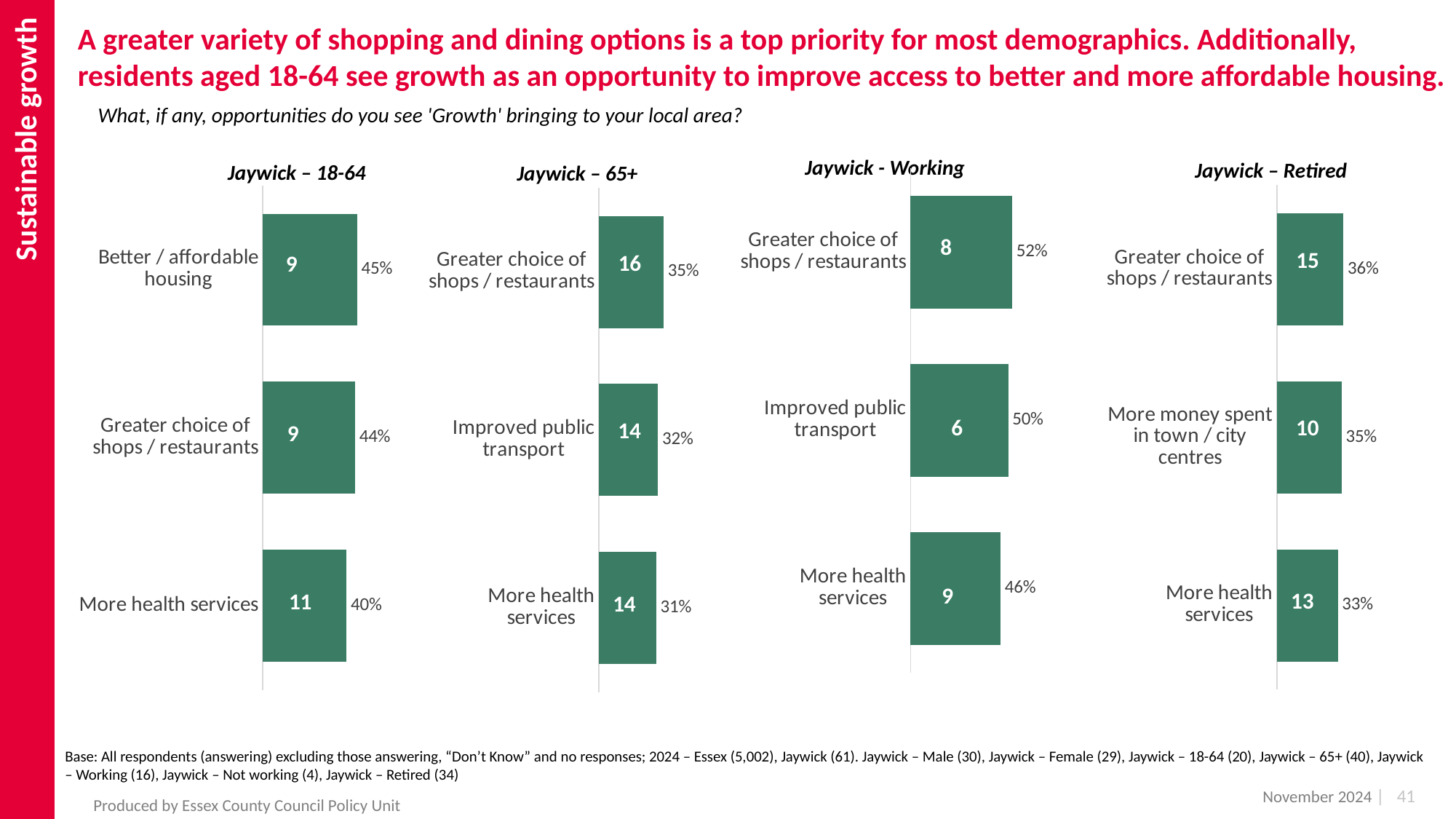
In the 'Jaywick – Retired' chart, what count is shown inside the bar for 'More money spent in town / city centres'? 10 How many categories are shown in the 'Jaywick – 65+' chart? 3 In the 'Jaywick – 65+' chart, which category has the highest percentage? Greater choice of shops / restaurants In the 'Jaywick – 18-64' chart, what percentage is shown for 'Better / affordable housing'? 45% In the 'Jaywick - Working' chart, what percentage is shown for 'Greater choice of shops / restaurants'? 52% In the 'Jaywick – 18-64' chart, what count is shown inside the bar for 'More health services'? 11 How many charts are shown on the slide? 4 In the 'Jaywick – 65+' chart, what percentage is shown for 'Improved public transport'? 32% In the 'Jaywick – Retired' chart, what is the difference in percentage points between 'Greater choice of shops / restaurants' and 'More health services'? 3 What type of chart is the 'Jaywick – Retired' chart? Bar chart In the 'Jaywick - Working' chart, which has the larger percentage: 'Greater choice of shops / restaurants' or 'Improved public transport'? Greater choice of shops / restaurants In the 'Jaywick - Working' chart, which category has the lowest percentage? More health services